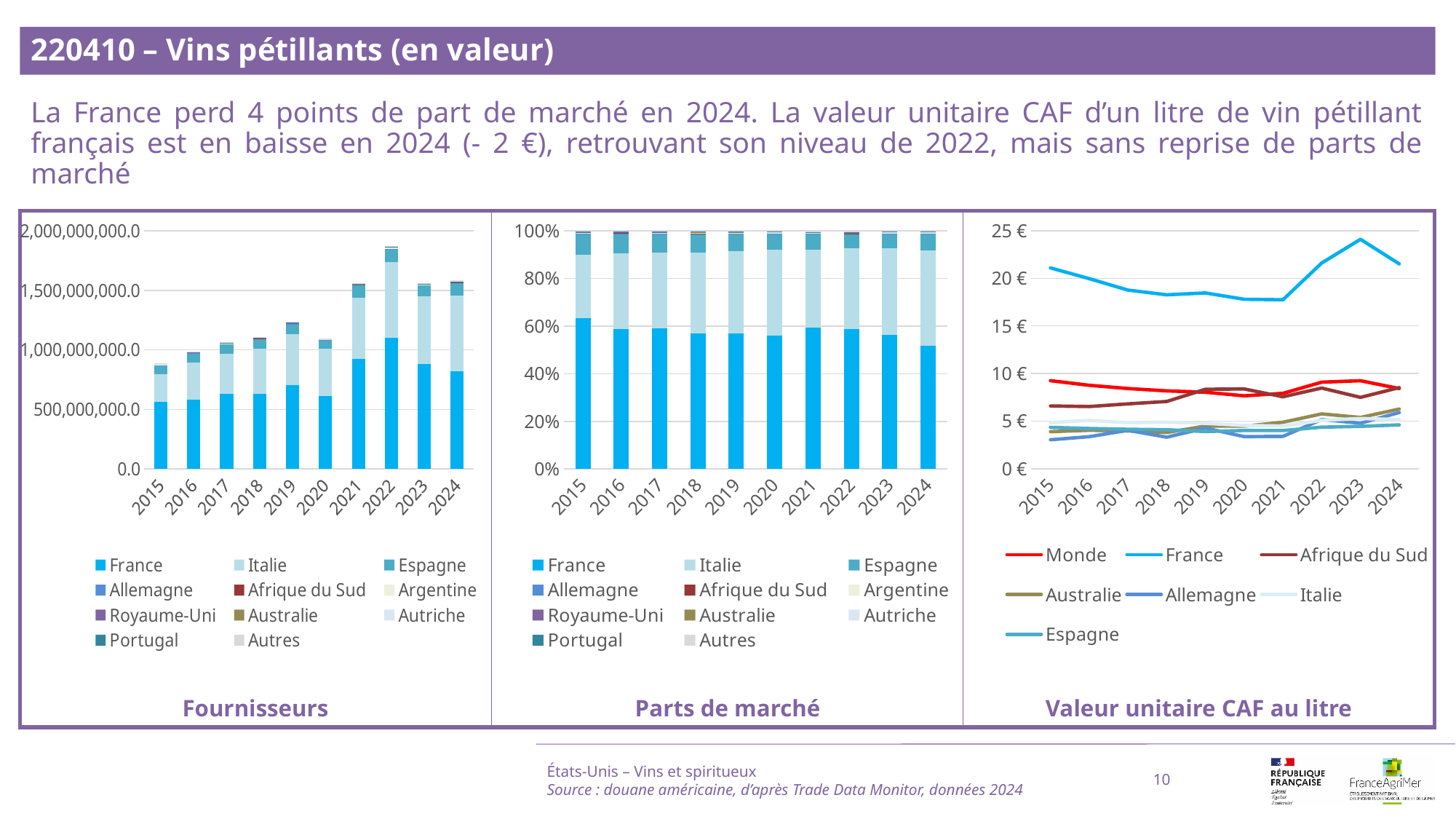
In the 'Fournisseurs' chart, is the total bar for 2015 greater or less than 1,000,000,000.0? less In the 'Valeur unitaire CAF au litre' chart, how many series does the legend list? 7 In the 'Valeur unitaire CAF au litre' chart, which series has the highest value in 2023? France What kind of chart is the 'Valeur unitaire CAF au litre' chart on the right? line chart In the 'Fournisseurs' chart, how many years are shown on the x axis? 10 In the 'Valeur unitaire CAF au litre' chart, is the France value in 2023 greater or less than 20 €? greater In the 'Parts de marché' chart, is the France share in 2015 greater or less than 60%? greater What kind of chart is the 'Fournisseurs' chart on the left? bar chart In the 'Fournisseurs' chart, which year has the tallest total bar? 2022 In the 'Fournisseurs' chart, how many series does the legend list? 11